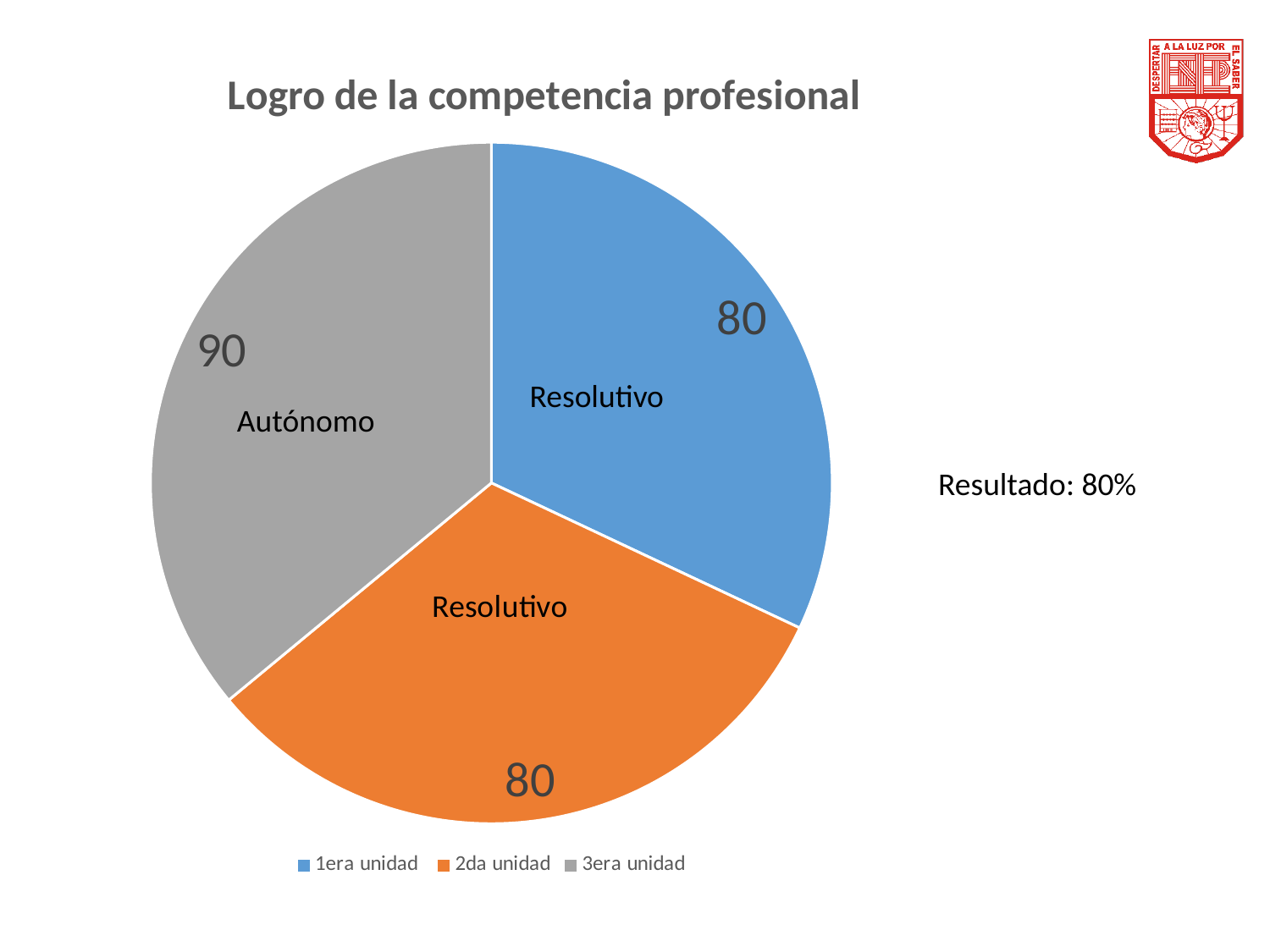
What share of the pie does 3era unidad represent? 36% What is the title of the chart? Logro de la competencia profesional Which unit has the highest value? 3era unidad What is the value for 3era unidad? 90 What kind of chart is shown on the slide? pie chart Which is larger, the value for 3era unidad or the value for 2da unidad? 3era unidad What is the value for 1era unidad? 80 How many slices does the pie chart have? 3 What text label is shown inside the 3era unidad slice? Autónomo How many entries does the legend list? 3 What is the value for 2da unidad? 80 What is the difference between the values for 3era unidad and 1era unidad? 10